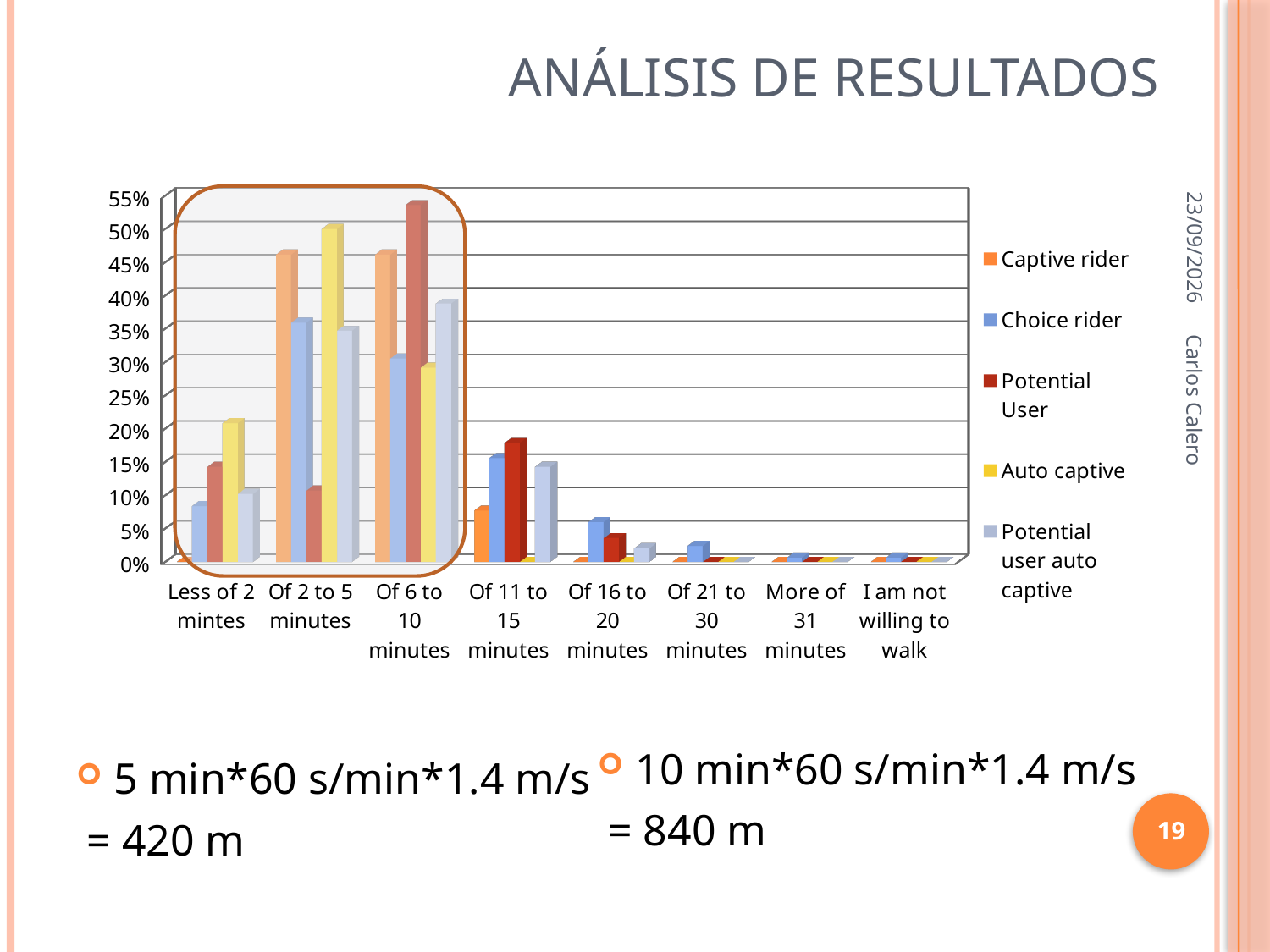
Is the 'Potential user auto captive' value for 'Of 6 to 10 minutes' greater or less than 35%? greater Is the Choice rider value for 'Less of 2 mintes' greater or less than 10%? less Is the Captive rider value for 'Of 2 to 5 minutes' greater or less than 40%? greater Which colour represents the Auto captive series in the legend? Yellow How many walking-time categories are shown on the x axis of the chart? 8 What kind of chart is shown on the slide? Bar chart In the 'Of 2 to 5 minutes' category, which is larger: Auto captive or Potential User? Auto captive Which series has the tallest bar in the 'Of 6 to 10 minutes' category? Potential User How many series does the chart's legend list? 5 In the 'Less of 2 mintes' category, which is larger: Auto captive or Choice rider? Auto captive In which category is the Potential User bar the highest? Of 6 to 10 minutes